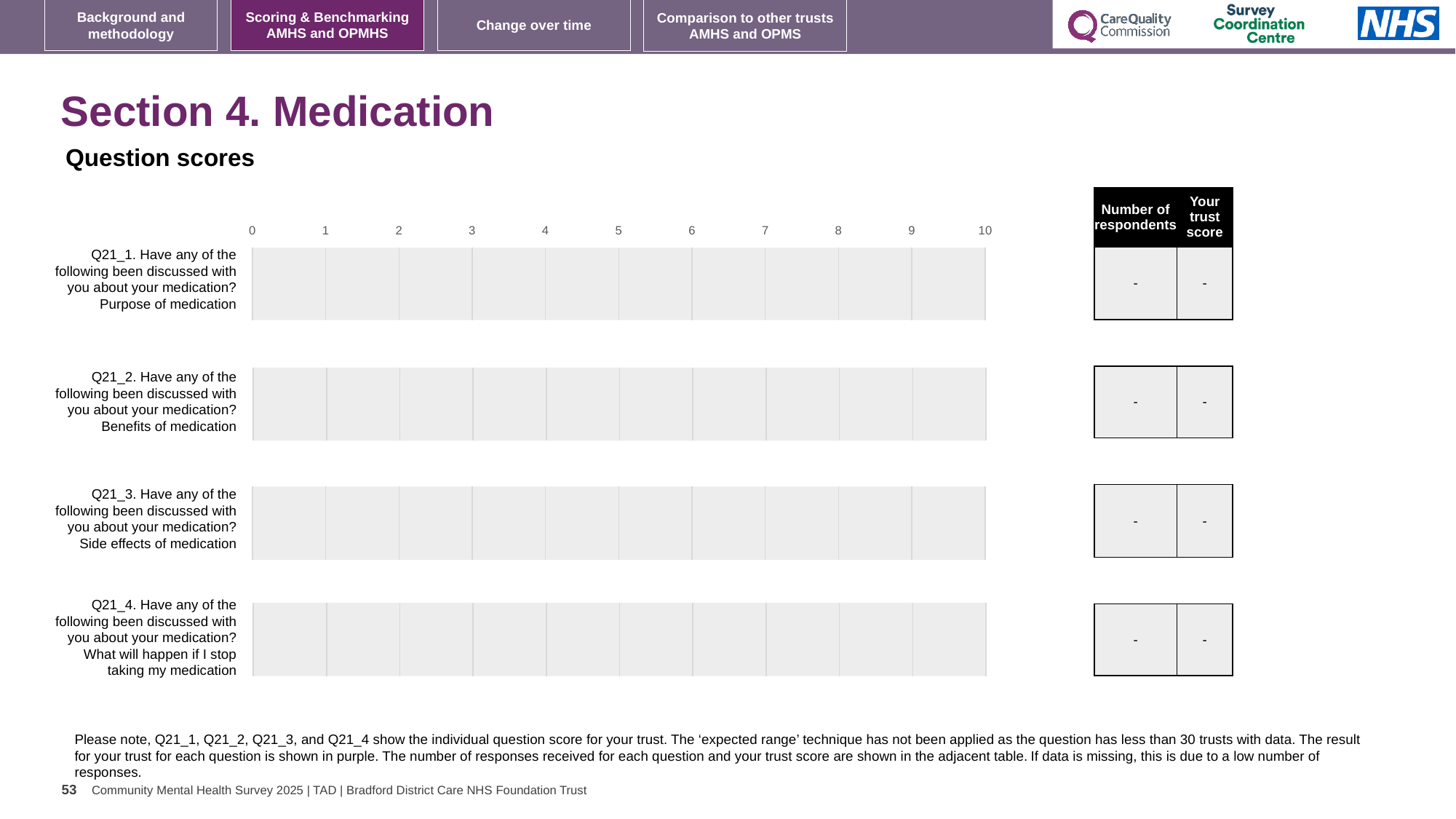
Which question label is shown for the bottom chart row? Q21_4. Have any of the following been discussed with you about your medication? What will happen if I stop taking my medication How many question rows (categories) are shown in the chart area on the slide? 4 What is the lowest value shown on the horizontal axis of the charts? 0 What value is shown for 'Your trust score' for Q21_4 in the adjacent table? - Are any data bars plotted for Q21_1 in the chart? No What value is shown for 'Number of respondents' for Q21_2 in the adjacent table? - What is the highest value shown on the horizontal axis of the charts? 10 What kind of chart layout is used for the question scores on this slide? bar chart